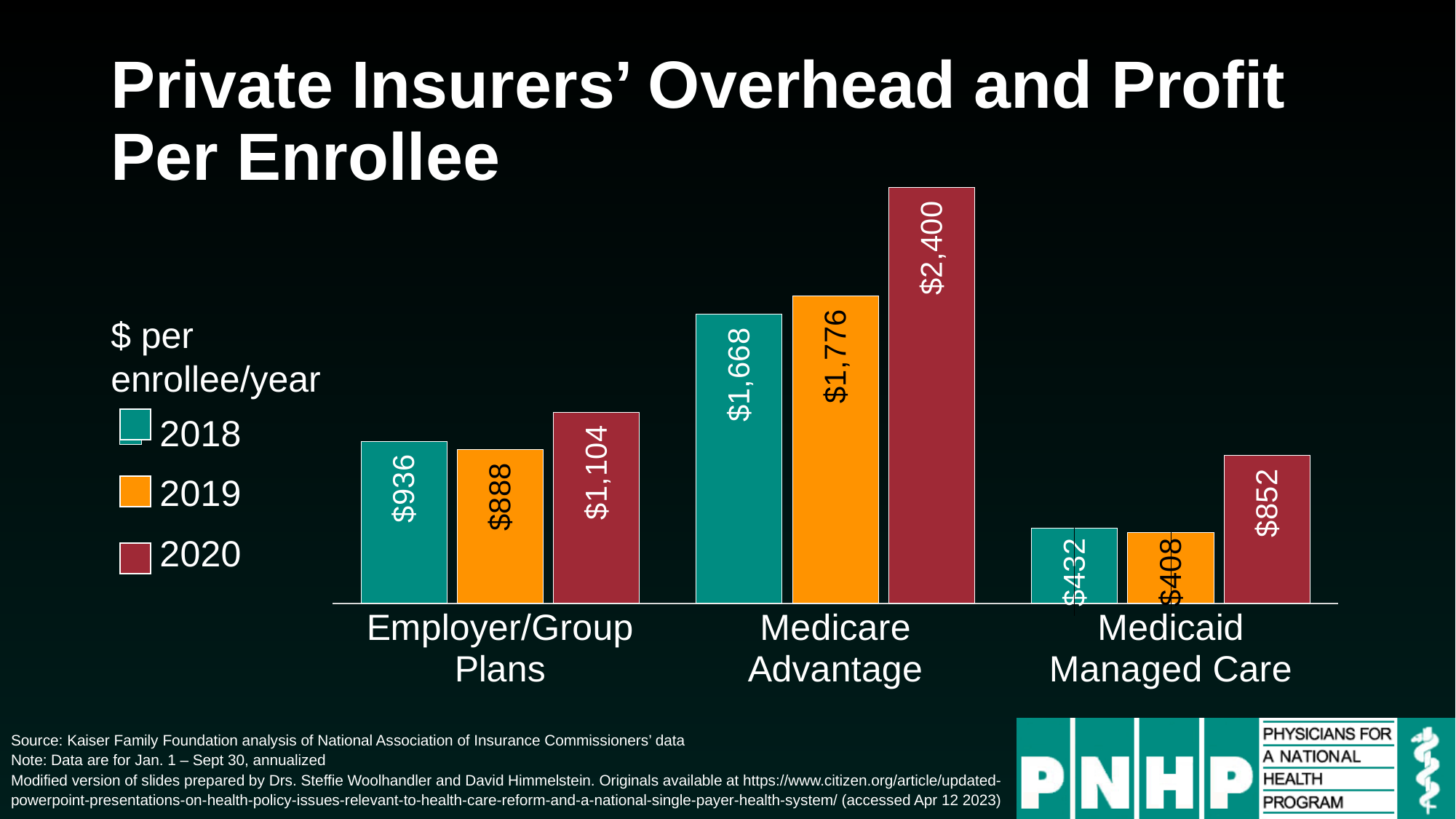
How many series does the legend list? 3 Which is larger for Employer/Group Plans, the 2018 value or the 2019 value? 2018 What is the 2019 value for Medicaid Managed Care? $408 How many categories are shown on the x axis? 3 Which category has the lowest 2019 value? Medicaid Managed Care Which category has the highest 2020 value? Medicare Advantage What is the difference between the 2020 and 2019 values for Medicare Advantage? $624 What kind of chart is shown on the slide? Bar chart What is the 2020 value for Medicare Advantage? $2,400 Which colour represents the 2019 series in the legend? Orange What is the difference between the 2020 and 2018 values for Medicaid Managed Care? $420 What is the 2018 value for Employer/Group Plans? $936